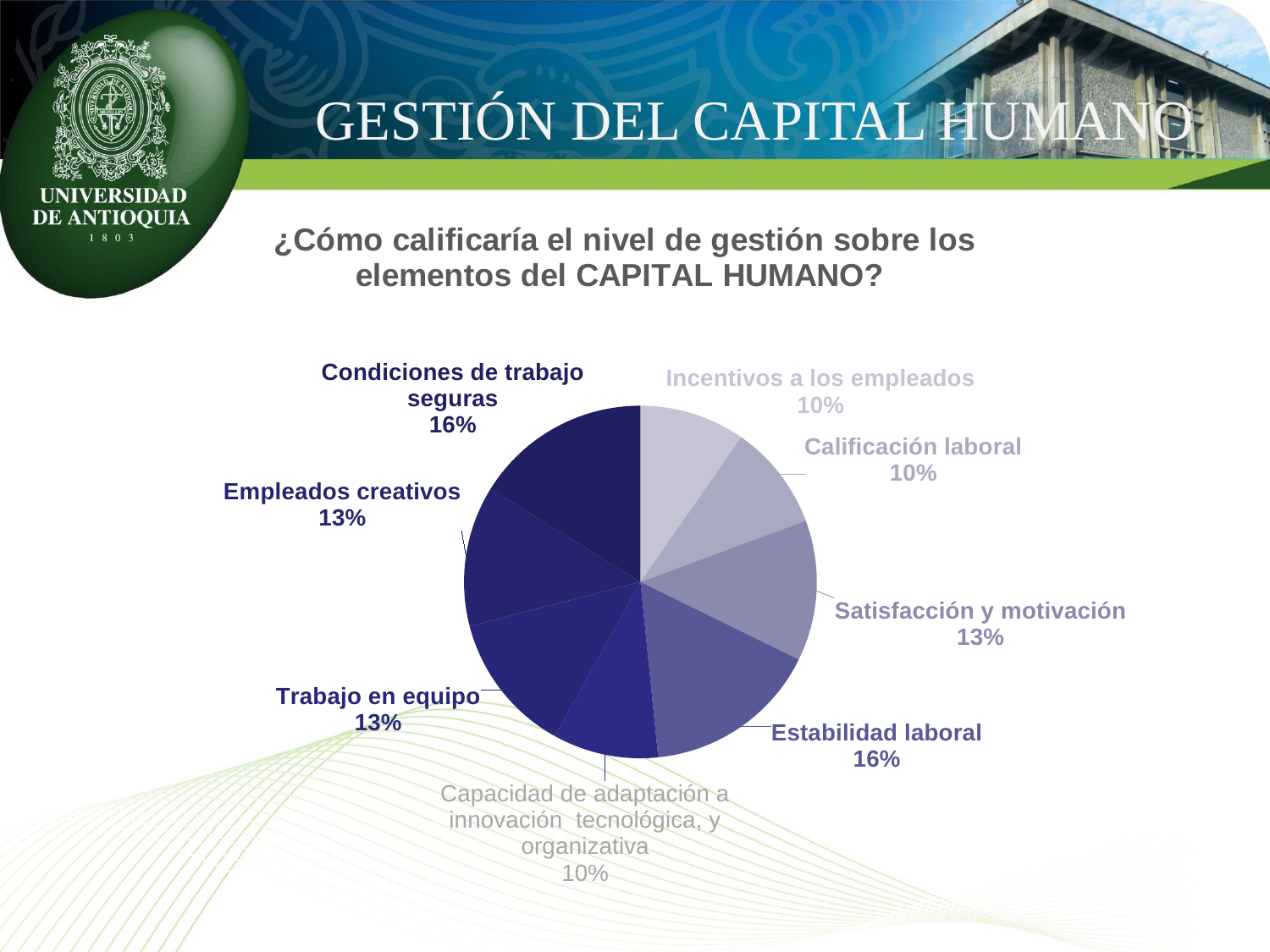
What percentage is shown for Incentivos a los empleados? 10% What percentage is shown for Satisfacción y motivación? 13% What is the combined share of Trabajo en equipo and Empleados creativos? 26% What percentage is shown for Condiciones de trabajo seguras? 16% What percentage is shown for Trabajo en equipo? 13% Which is larger, Empleados creativos or Incentivos a los empleados? Empleados creativos How many slices does the pie chart have? 8 What percentage is shown for Estabilidad laboral? 16% What type of chart is shown on the slide? pie chart What percentage is shown for Capacidad de adaptación a innovación tecnológica, y organizativa? 10% What is the difference in percentage points between Estabilidad laboral and Calificación laboral? 6 What question is posed as the heading above the pie chart? ¿Cómo calificaría el nivel de gestión sobre los elementos del CAPITAL HUMANO?